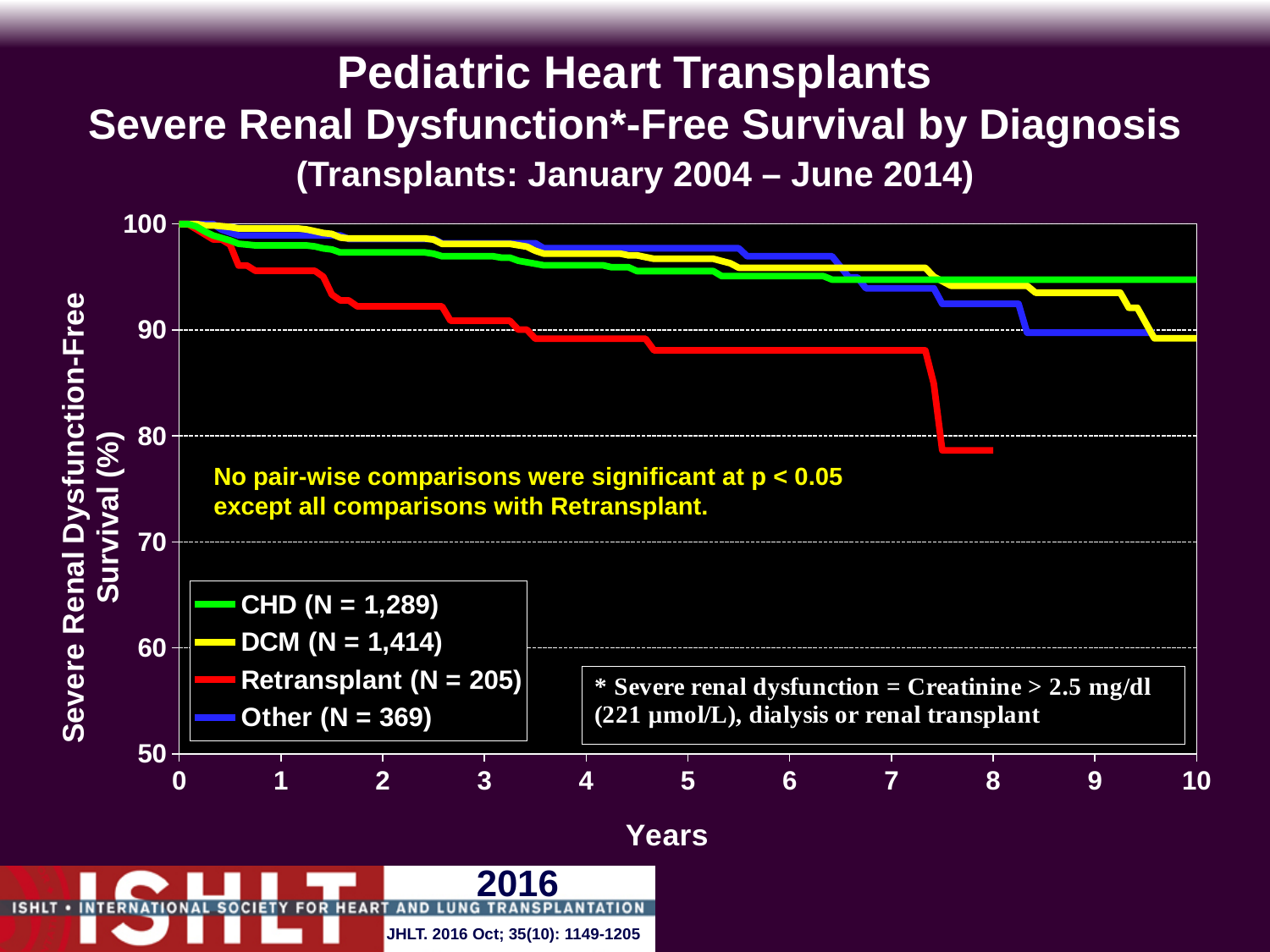
At 3 years, which is higher: the DCM curve or the Retransplant curve? DCM How many series does the legend list? 4 Which diagnosis group has the lowest severe renal dysfunction-free survival at 8 years? Retransplant Is the value for Retransplant at 7 years greater or less than 90? less Is the value for CHD at 10 years greater or less than 90? greater According to the legend, what is the N for the Retransplant group? 205 At 5 years, which is higher: the CHD curve or the Retransplant curve? CHD Do the survival curves rise or fall as years increase along the x axis? fall Is the value for Retransplant at 8 years greater or less than 80? less Which diagnosis group has the largest N in the legend? DCM (N = 1,414) What kind of chart is shown on the slide? line chart